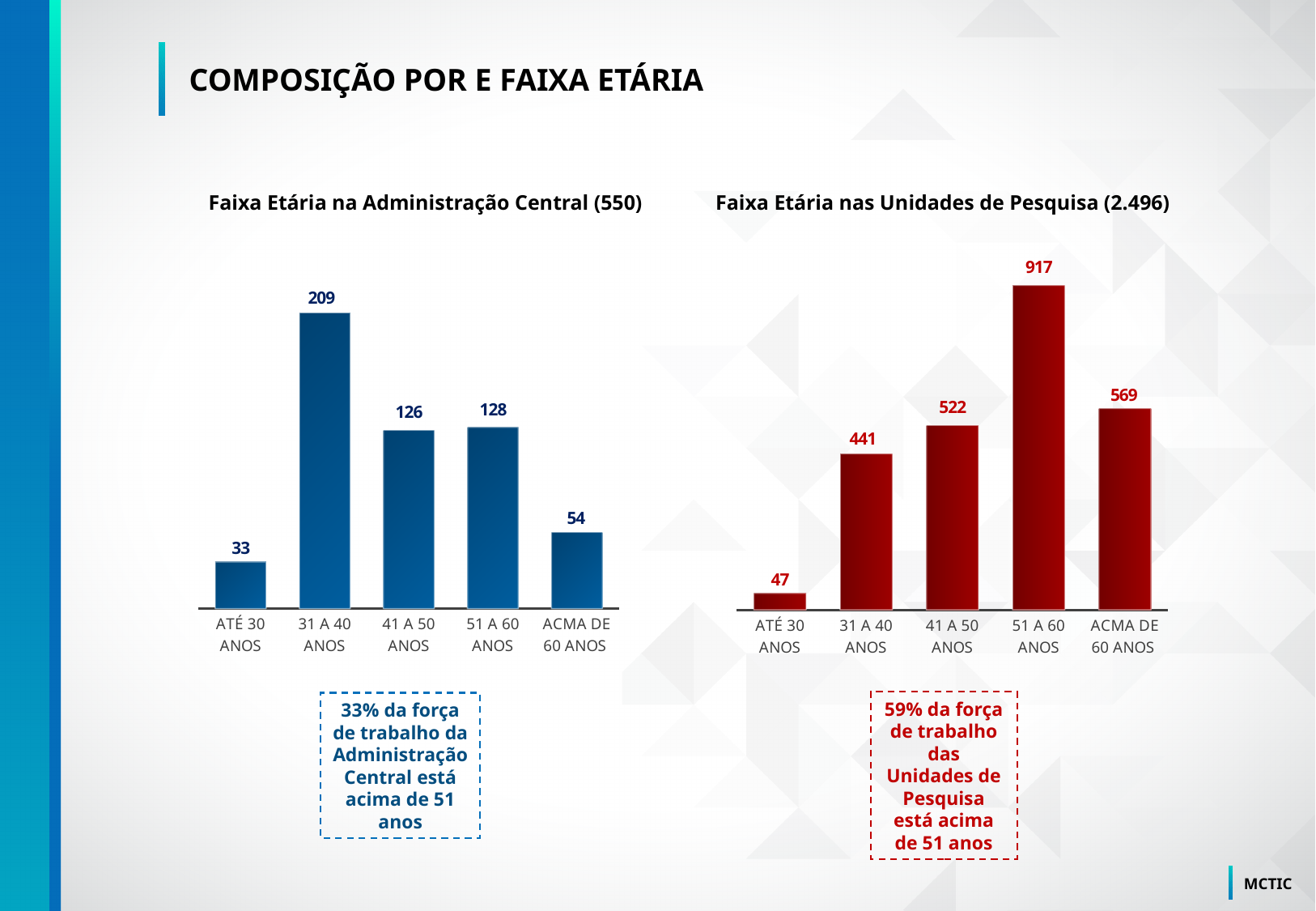
What kind of chart is 'Faixa Etária nas Unidades de Pesquisa (2.496)'? Bar chart In the chart 'Faixa Etária na Administração Central (550)', which age group has the lowest value? ATÉ 30 ANOS In the chart 'Faixa Etária nas Unidades de Pesquisa (2.496)', what is the value for ACMA DE 60 ANOS? 569 In the chart 'Faixa Etária na Administração Central (550)', what is the difference between the values for 31 A 40 ANOS and ATÉ 30 ANOS? 176 How many age groups are shown in the chart 'Faixa Etária na Administração Central (550)'? 5 In the chart 'Faixa Etária na Administração Central (550)', what is the value for ATÉ 30 ANOS? 33 In the chart 'Faixa Etária nas Unidades de Pesquisa (2.496)', what is the difference between the values for 51 A 60 ANOS and 41 A 50 ANOS? 395 In the chart 'Faixa Etária na Administração Central (550)', which is larger: the value for 41 A 50 ANOS or 51 A 60 ANOS? 51 A 60 ANOS In the chart 'Faixa Etária nas Unidades de Pesquisa (2.496)', which age group has the highest value? 51 A 60 ANOS What colour are the bars in the chart 'Faixa Etária nas Unidades de Pesquisa (2.496)'? Red In the chart 'Faixa Etária nas Unidades de Pesquisa (2.496)', which is larger: the value for 31 A 40 ANOS or ACMA DE 60 ANOS? ACMA DE 60 ANOS In the chart 'Faixa Etária na Administração Central (550)', what is the value for 31 A 40 ANOS? 209